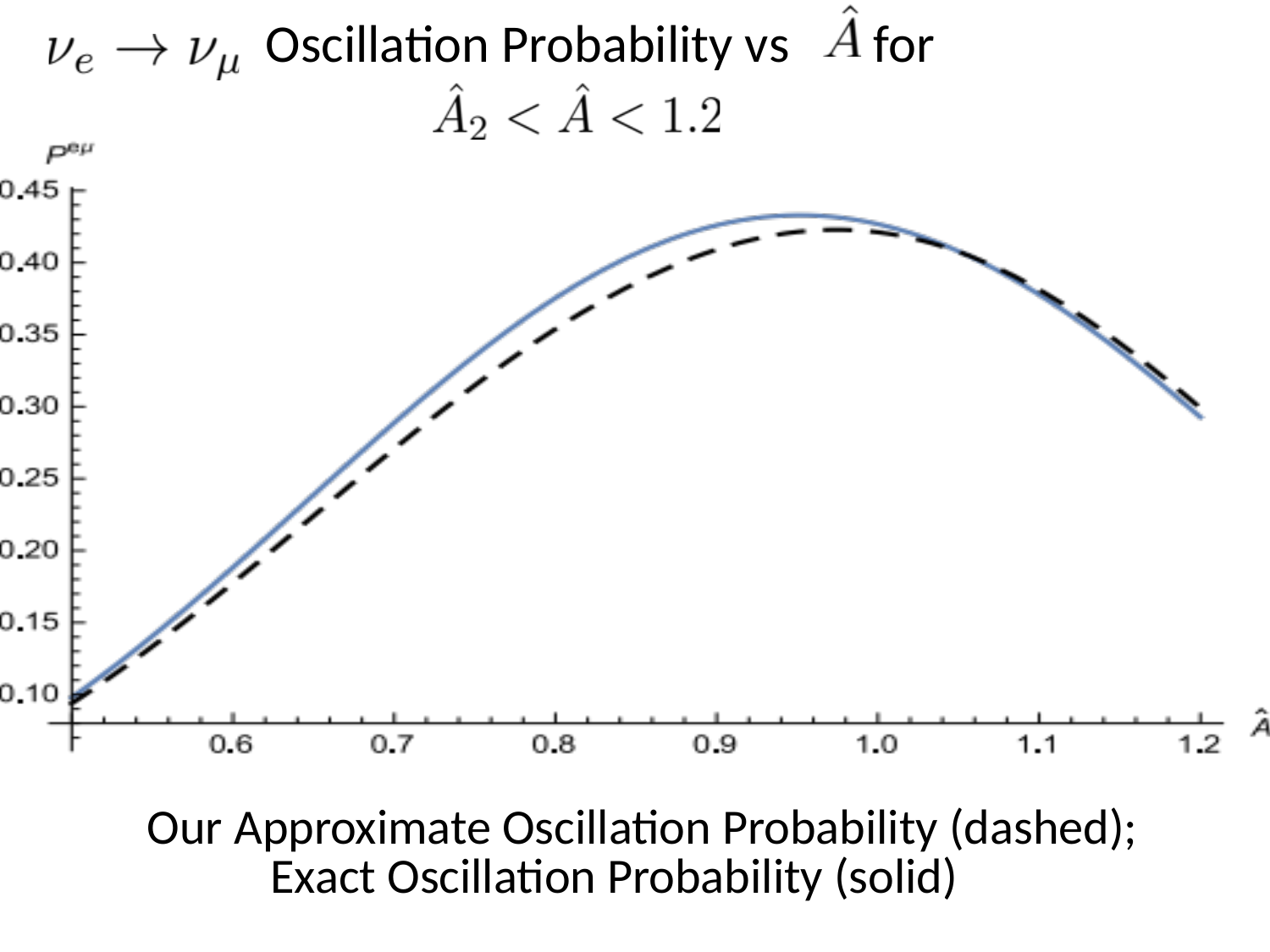
Is the value of the dashed curve at Â = 0.6 greater or less than 0.15? greater What kind of chart is shown on the slide? line chart Which line style represents the approximate oscillation probability? dashed Which line style represents the exact oscillation probability? solid At Â = 0.8, which curve has the higher value, the solid or the dashed? solid How many curves are plotted on the chart? 2 Is the value of the solid curve at Â = 0.8 greater or less than 0.30? greater Do the curves rise or fall as Â increases from 1.0 to 1.2? fall Is the peak value of the solid curve greater or less than 0.40? greater Which curve reaches the higher peak value, the solid or the dashed? solid Do the curves rise or fall as Â increases from 0.6 to 0.9? rise